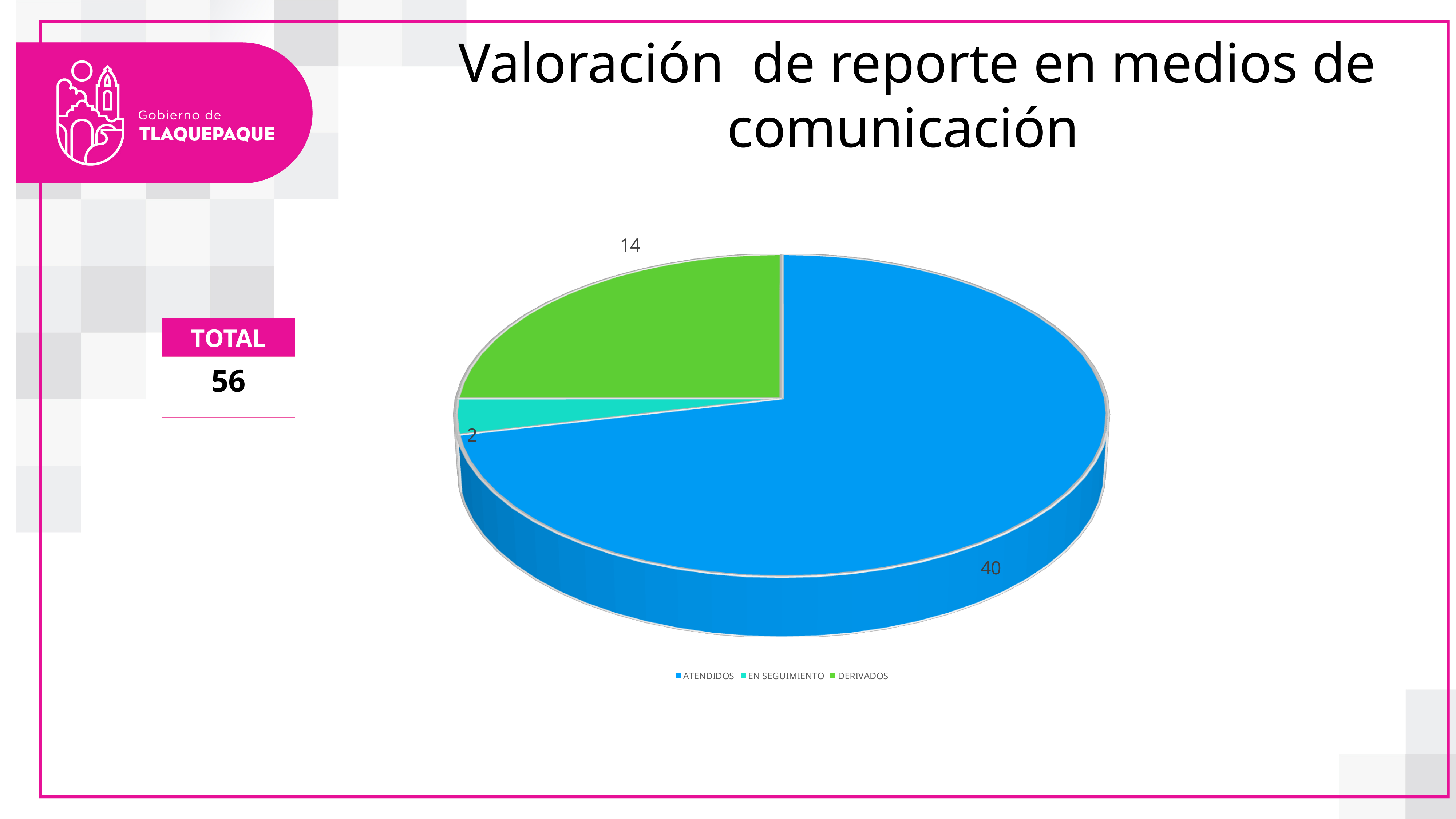
What is the value for ATENDIDOS? 40 Which category has the largest slice? ATENDIDOS How many categories does the pie chart show? 3 Which is larger, DERIVADOS or EN SEGUIMIENTO? DERIVADOS What is the value for EN SEGUIMIENTO? 2 What is the value for DERIVADOS? 14 What is the total of all slices in the pie chart? 56 What kind of chart is shown on the slide? pie chart Which category has the smallest slice? EN SEGUIMIENTO What colour is the ATENDIDOS slice? blue What is the difference between the values for ATENDIDOS and DERIVADOS? 26 What is the difference between the values for DERIVADOS and EN SEGUIMIENTO? 12